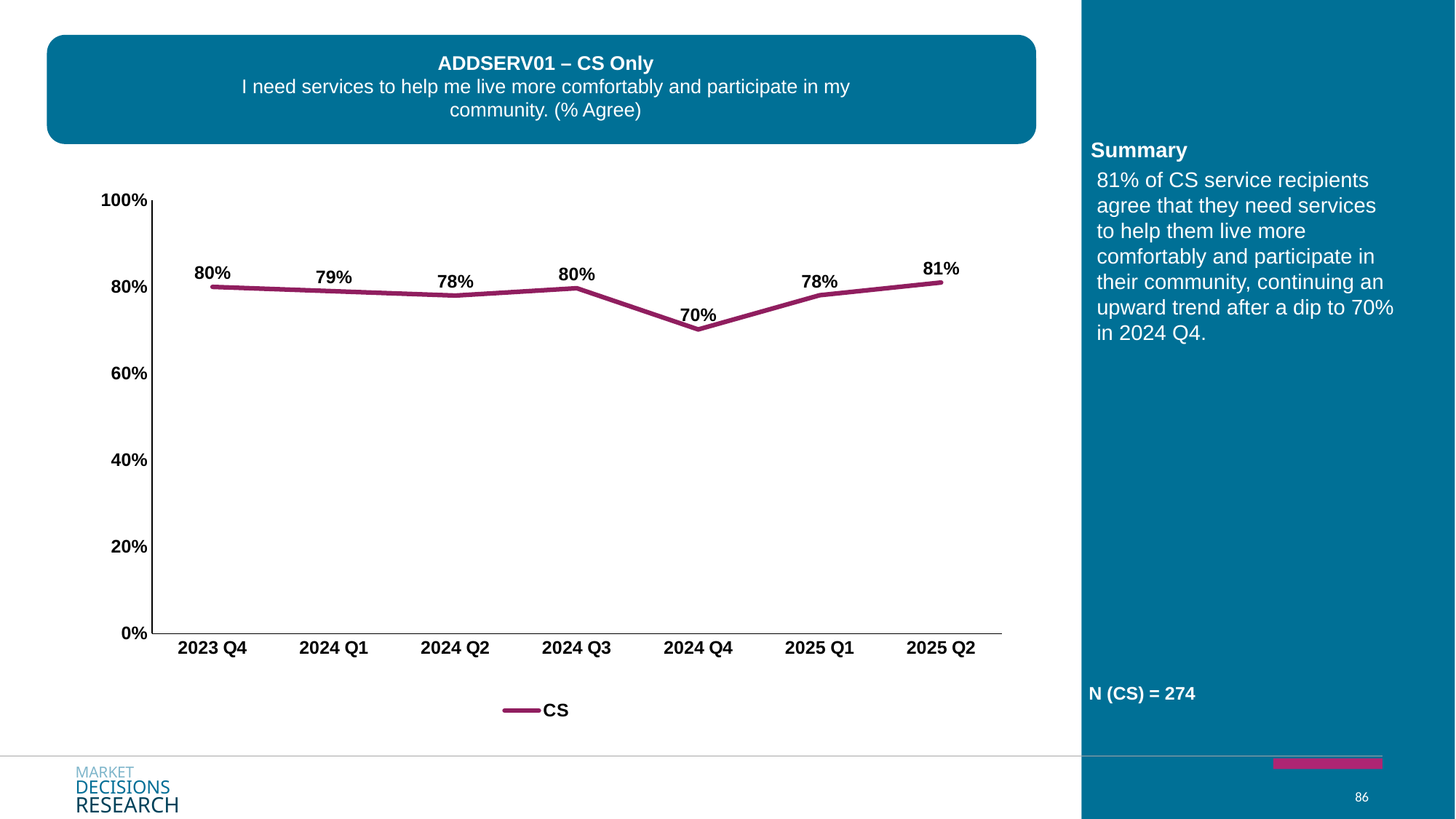
What is the value for 2024 Q4? 70% What is the value for 2025 Q2? 81% Which is larger, the value for 2023 Q4 or the value for 2024 Q4? 2023 Q4 What is the name of the series shown in the legend? CS Which quarter has the highest value? 2025 Q2 What is the value for 2024 Q1? 79% What kind of chart is shown? line chart Which quarter has the lowest value? 2024 Q4 How many series does the legend list? 1 How many quarters are plotted on the x axis? 7 Is the value for 2024 Q4 greater or less than 80%? less What is the difference between the values for 2025 Q2 and 2024 Q4? 11%